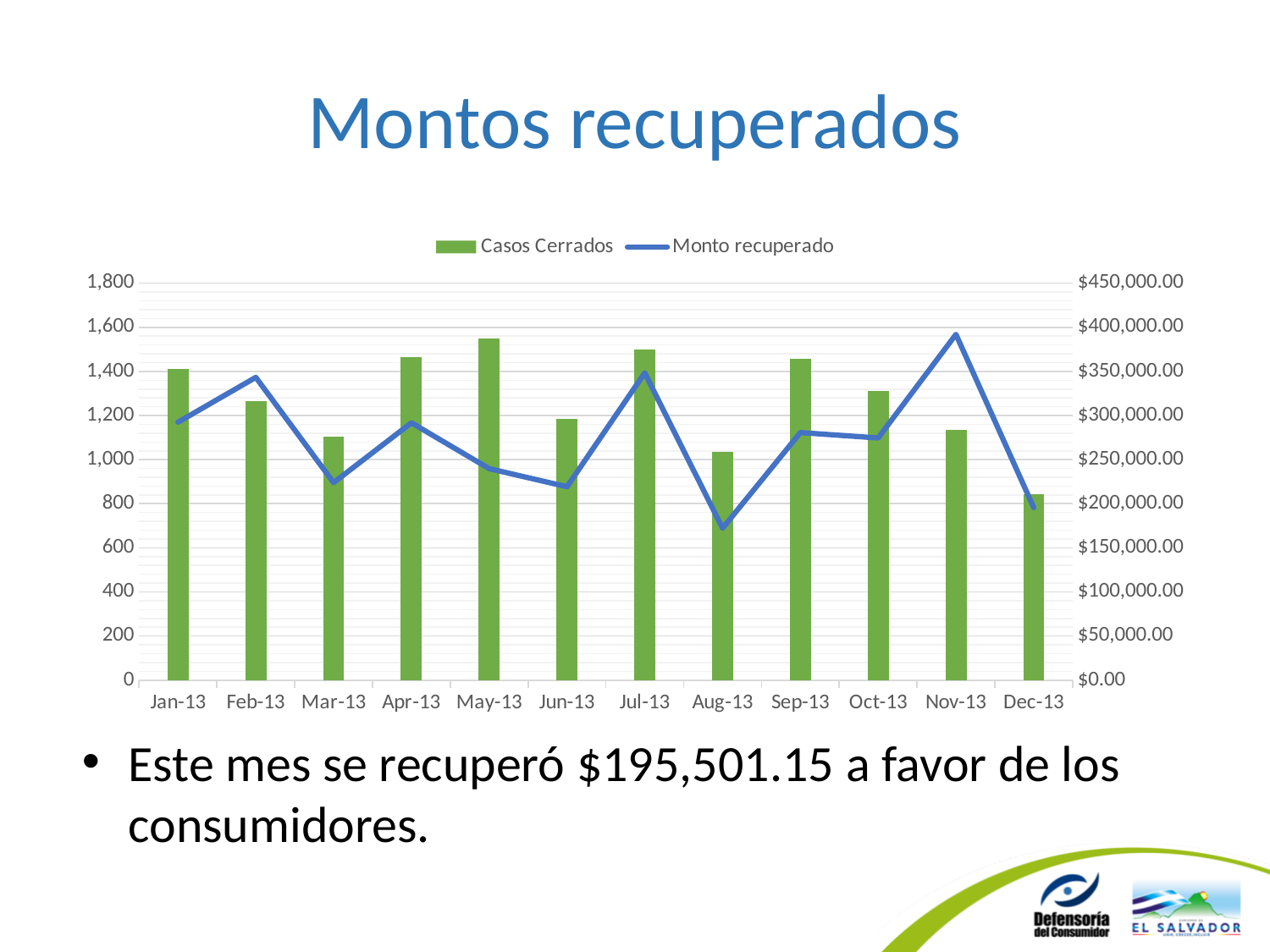
Which month has more Casos Cerrados, Jan-13 or Feb-13? Jan-13 Is the Monto recuperado value for Nov-13 greater or less than $350,000.00? greater What kind of chart is shown on the slide? Combined bar and line chart How many series does the chart legend list? 2 In which month does the Monto recuperado line reach its lowest point? Aug-13 Does the Monto recuperado line rise or fall from Nov-13 to Dec-13? fall How many months are shown on the x axis of the chart? 12 Is the Monto recuperado value for Aug-13 greater or less than $200,000.00? less In which month does the Monto recuperado line reach its highest point? Nov-13 Which month has the lowest Casos Cerrados bar? Dec-13 Which month has the highest Casos Cerrados bar? May-13 Is the Casos Cerrados value for Dec-13 greater or less than 1,000? less